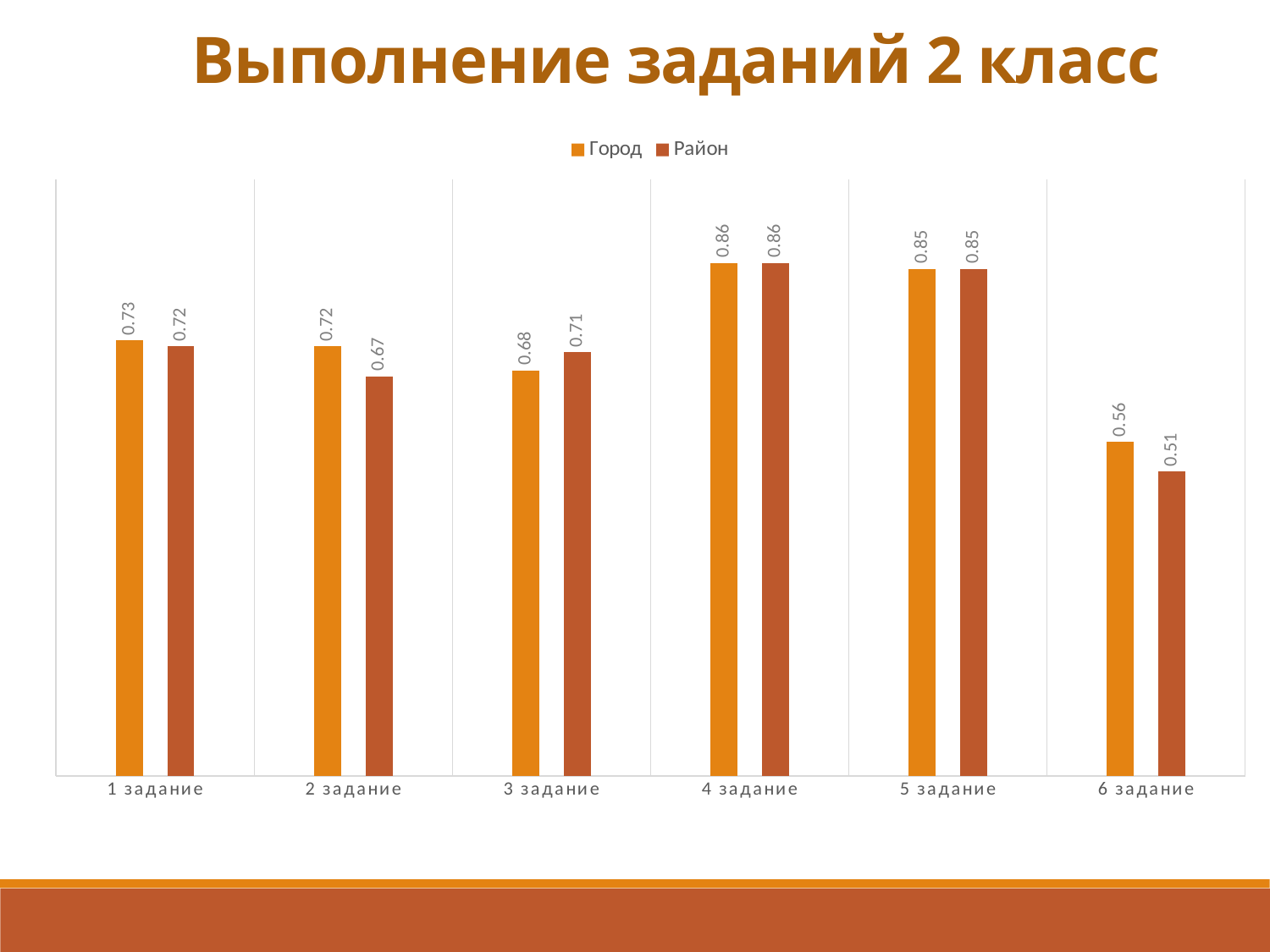
What is the value for Город for 6 задание? 0.56 How many categories are shown on the x axis? 6 What is the value for Город for 1 задание? 0.73 Which category has the highest value for Город? 4 задание For 3 задание, which is larger: Город or Район? Район Which category has the lowest value for Район? 6 задание What is the value for Район for 3 задание? 0.71 How many series does the legend list? 2 What is the difference between Город and Район for 6 задание? 0.05 What kind of chart is shown on the slide? Bar chart What is the value for Район for 2 задание? 0.67 What is the difference between Город and Район for 2 задание? 0.05